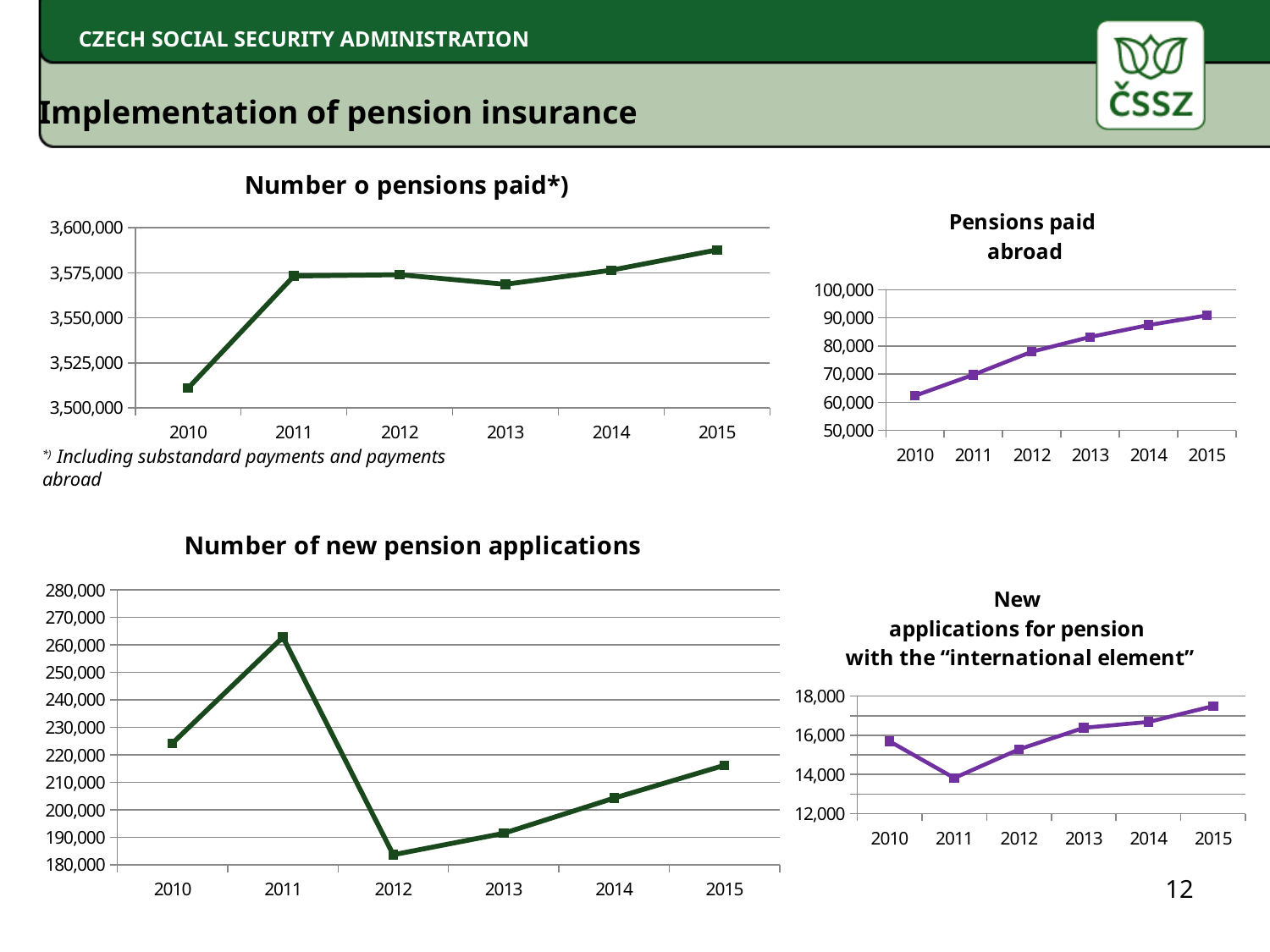
In the 'Number o pensions paid*)' chart, which year has the lowest value? 2010 In the 'Number of new pension applications' chart, which year has the highest value? 2011 How many charts are shown on the slide? 4 In the 'Number o pensions paid*)' chart, which year has the highest value? 2015 In the 'New applications for pension with the "international element"' chart, which is larger, the value for 2010 or the value for 2015? 2015 In the 'Pensions paid abroad' chart, is the value for 2010 greater or less than 70,000? less In the 'Pensions paid abroad' chart, do the values rise or fall from 2010 to 2015? rise In the 'Number of new pension applications' chart, which year has the lowest value? 2012 In the 'Number o pensions paid*)' chart, is the value for 2010 greater or less than 3,525,000? less In the 'New applications for pension with the "international element"' chart, which year has the lowest value? 2011 In the 'Number of new pension applications' chart, is the value for 2011 greater or less than 260,000? greater